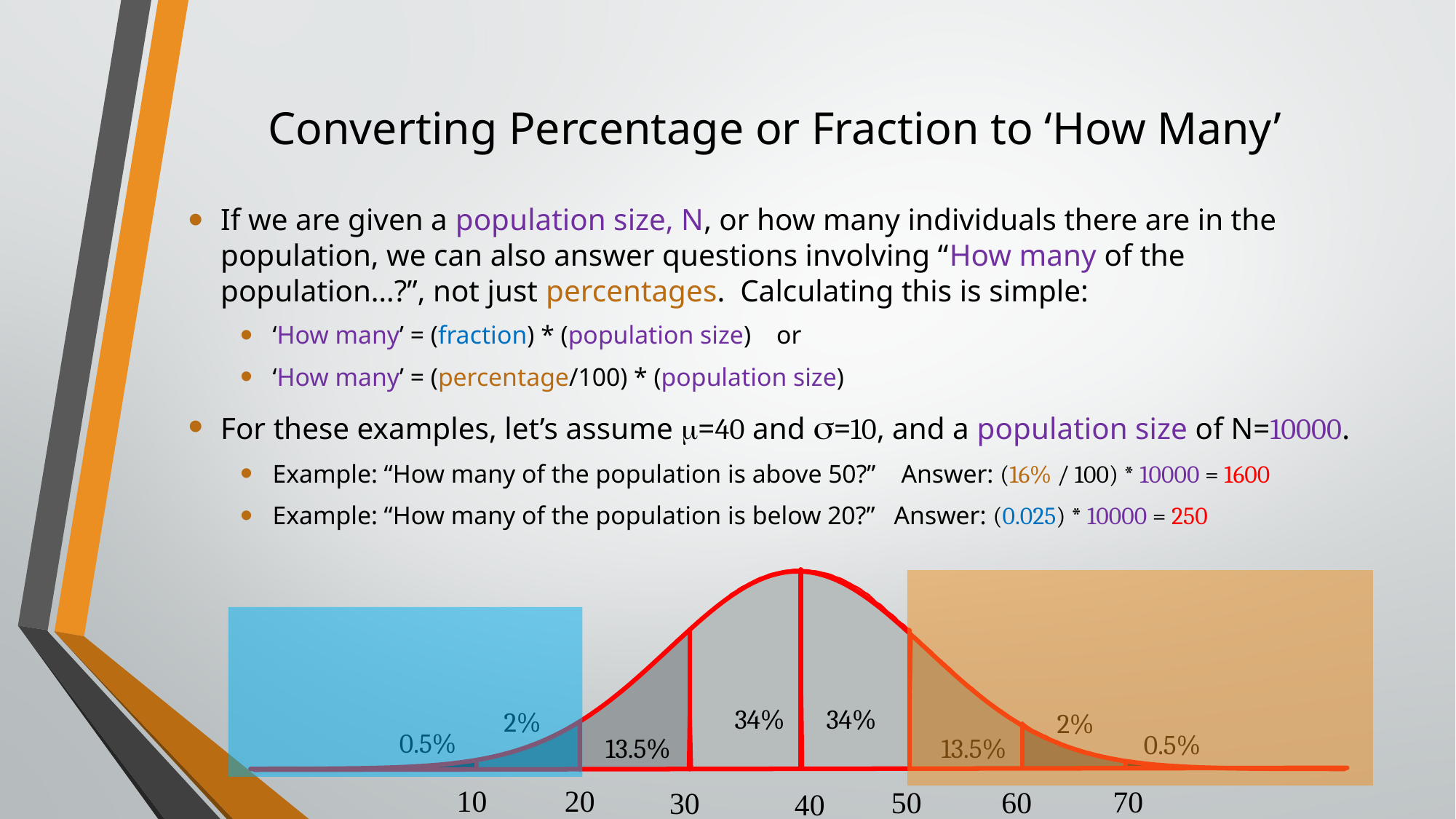
On the bell curve diagram, what percentage is labeled for the region between 30 and 40? 34% On the bell curve diagram, what is the total percentage covered by the blue shaded region below 20? 2.5% How many numeric tick labels are shown along the x axis of the bell curve diagram? 7 On the bell curve diagram, what is the largest percentage label shown? 34% On the bell curve diagram, what is the difference between the percentage for the region between 40 and 50 and the percentage for the region between 50 and 60? 20.5% On the bell curve diagram, what percentage is labeled for the region between 60 and 70? 2% On the bell curve diagram, which is larger: the percentage for the region between 20 and 30 or the region between 10 and 20? The region between 20 and 30 On the bell curve diagram, what percentage is labeled for the region between 50 and 60? 13.5% At which x-axis value does the bell curve reach its peak? 40 On the bell curve diagram, what is the total percentage covered by the orange shaded region above 50? 16% On the bell curve diagram, what percentage is labeled for the region above 70? 0.5% On the bell curve diagram, what is the smallest percentage label shown? 0.5%